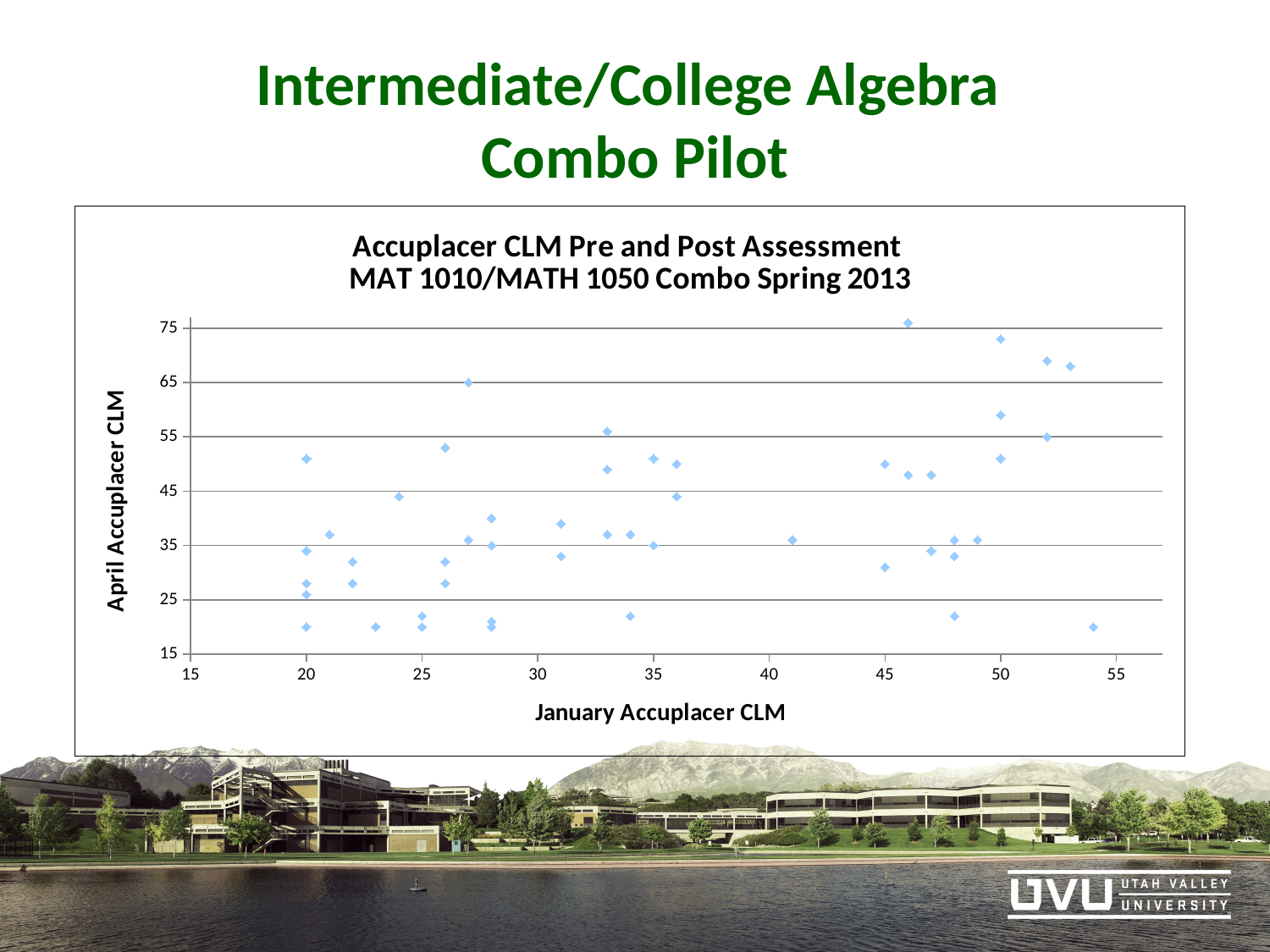
What is the title of the chart? Accuplacer CLM Pre and Post Assessment MAT 1010/MATH 1050 Combo Spring 2013 Is the lowest January Accuplacer CLM score plotted greater or less than 25? less Is the lowest April Accuplacer CLM score plotted greater or less than 25? less Is the highest April Accuplacer CLM score plotted greater or less than 65? greater What kind of chart is shown on the slide? Scatter plot What is the label of the vertical axis of the chart? April Accuplacer CLM